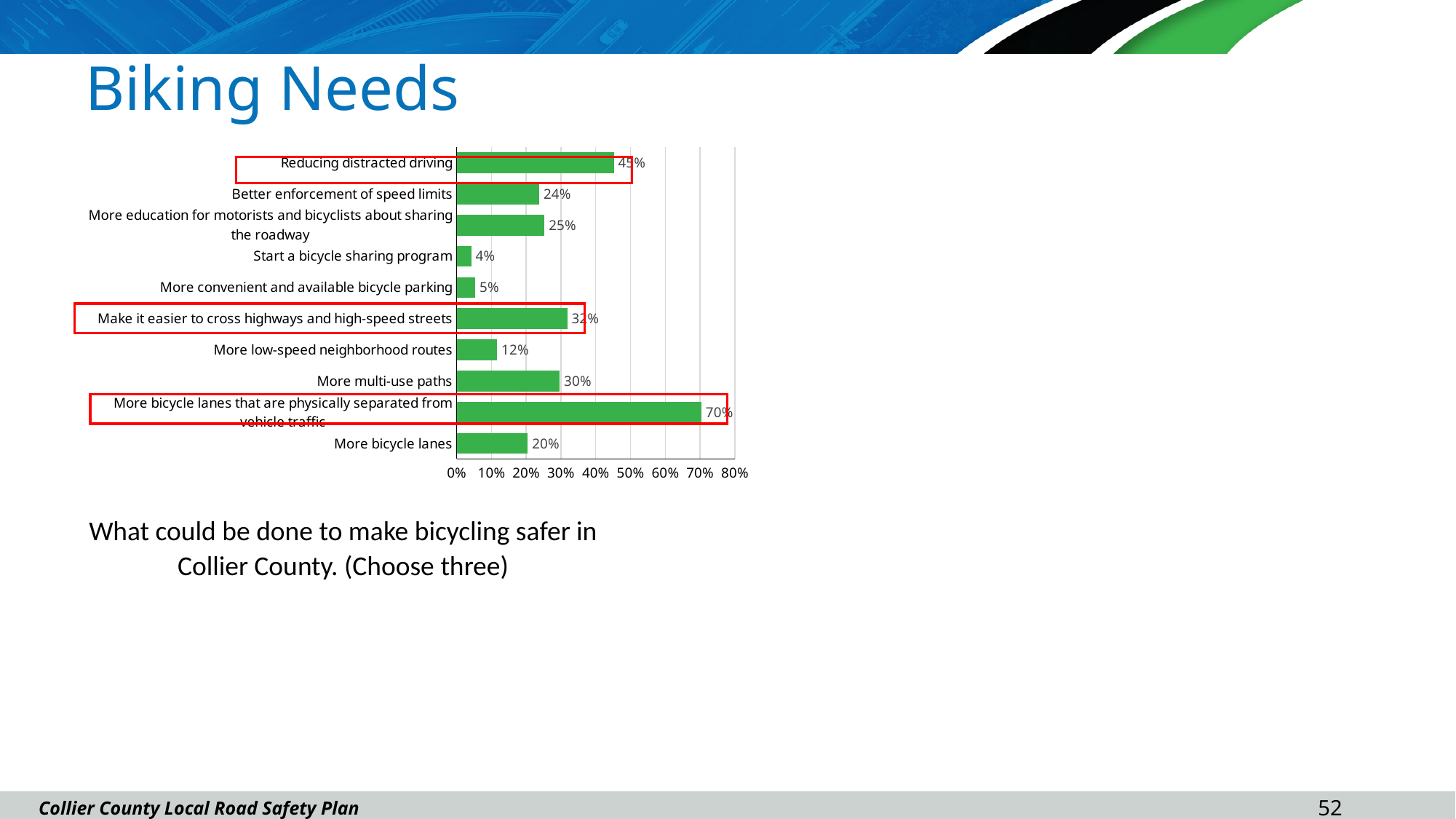
Which category has the lowest value? Start a bicycle sharing program What kind of chart is shown on the slide? Bar chart What is the value for "Start a bicycle sharing program"? 4% Which category has the highest value? More bicycle lanes that are physically separated from vehicle traffic Is the value for "Reducing distracted driving" greater or less than 40%? greater What is the difference between "Make it easier to cross highways and high-speed streets" and "More low-speed neighborhood routes"? 20% What is the value for "Reducing distracted driving"? 45% How many categories are highlighted with red boxes? 3 What is the value for "More multi-use paths"? 30% What percentage of respondents chose "More bicycle lanes that are physically separated from vehicle traffic"? 70% Which is larger: "Better enforcement of speed limits" or "More bicycle lanes"? Better enforcement of speed limits How many categories are shown in the chart? 10